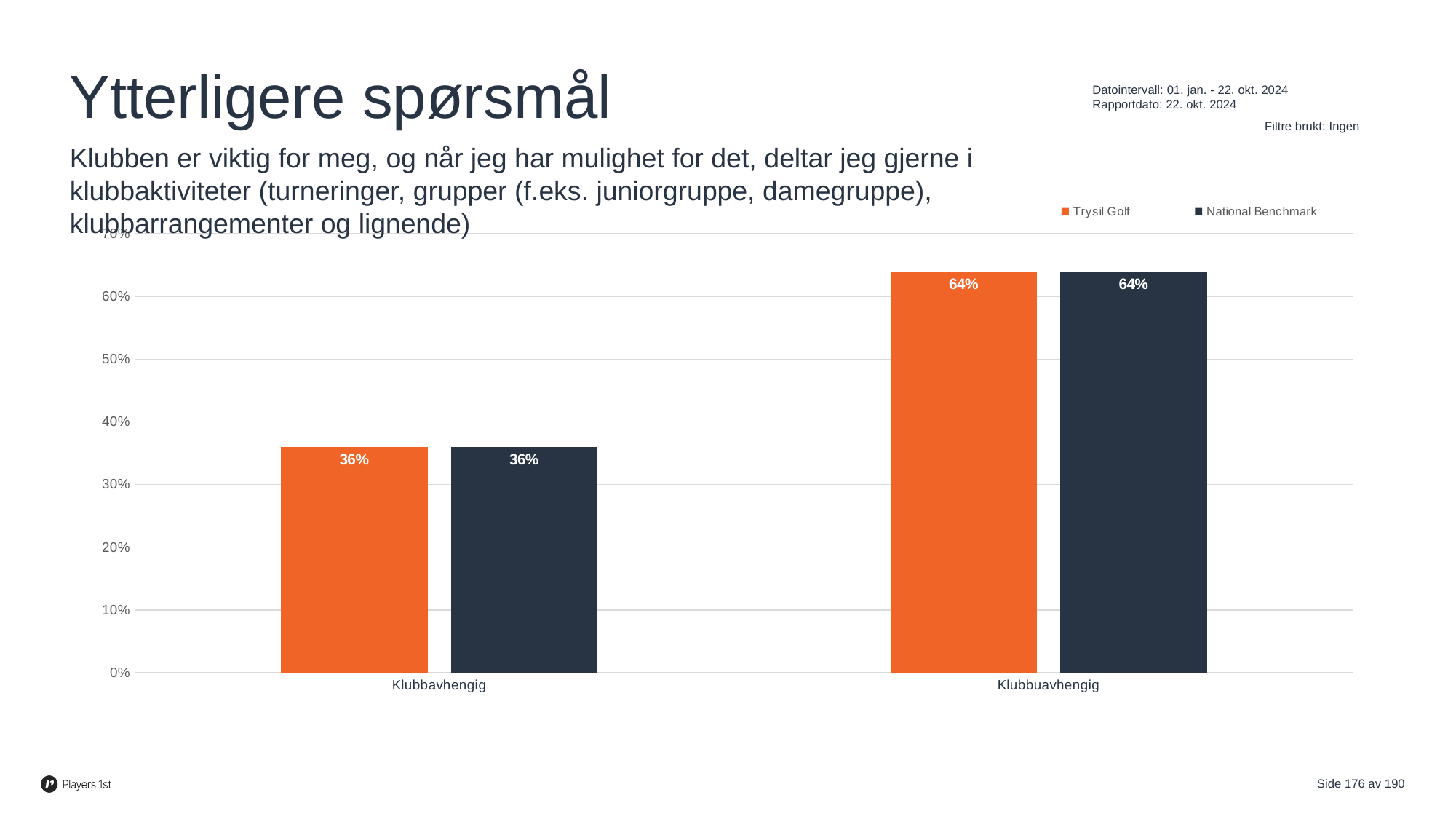
Which category has the lowest value for National Benchmark? Klubbavhengig What is the value for Trysil Golf in the Klubbuavhengig category? 64% What is the value for National Benchmark in the Klubbavhengig category? 36% What kind of chart is shown on the slide? Bar chart Which category has the highest value for Trysil Golf? Klubbuavhengig Which colour represents Trysil Golf in the chart? Orange How many categories are shown on the x axis? 2 What is the value for Trysil Golf in the Klubbavhengig category? 36% How many series does the legend list? 2 Which is larger for Trysil Golf: Klubbavhengig or Klubbuavhengig? Klubbuavhengig What is the value for National Benchmark in the Klubbuavhengig category? 64% What is the difference between the Trysil Golf values for Klubbuavhengig and Klubbavhengig? 28%